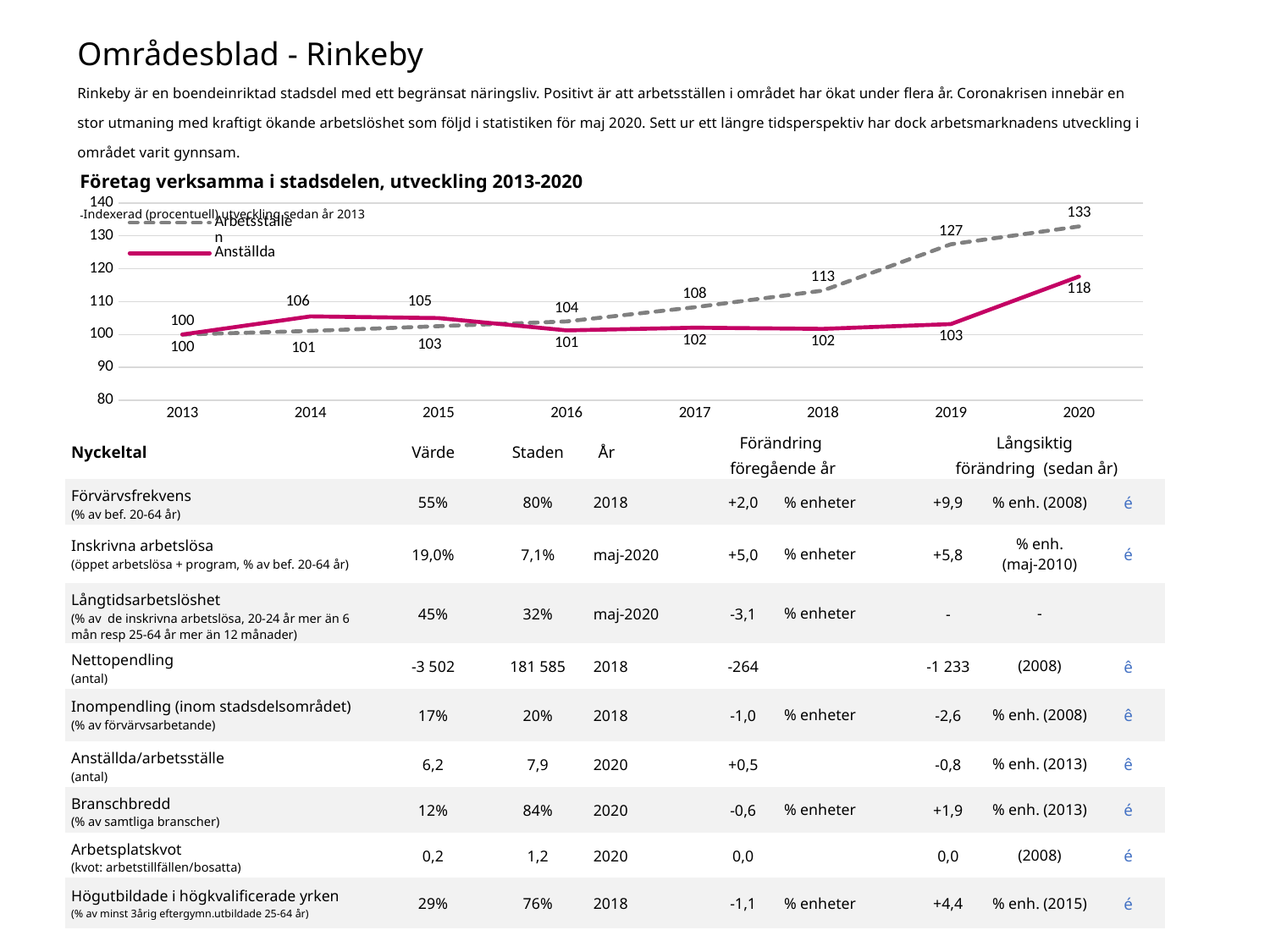
Does the Arbetsställen series rise or fall from 2013 to 2020 in the line chart? rise What is the value for Anställda in 2020 in the line chart? 118 What is the difference between Arbetsställen and Anställda in 2019 in the line chart? 24 What is the value for Arbetsställen in 2020 in the line chart? 133 How many series does the legend of the line chart list? 2 What is the value for Anställda in 2014 in the line chart? 106 In which year does Anställda have its lowest value in the line chart? 2013 How many years are plotted on the x axis of the line chart? 8 In 2015, which series has the higher value in the line chart, Arbetsställen or Anställda? Anställda In which year does Arbetsställen reach its highest value in the line chart? 2020 What is the value for Arbetsställen in 2018 in the line chart? 113 What type of chart is shown under the title 'Företag verksamma i stadsdelen, utveckling 2013-2020'? line chart